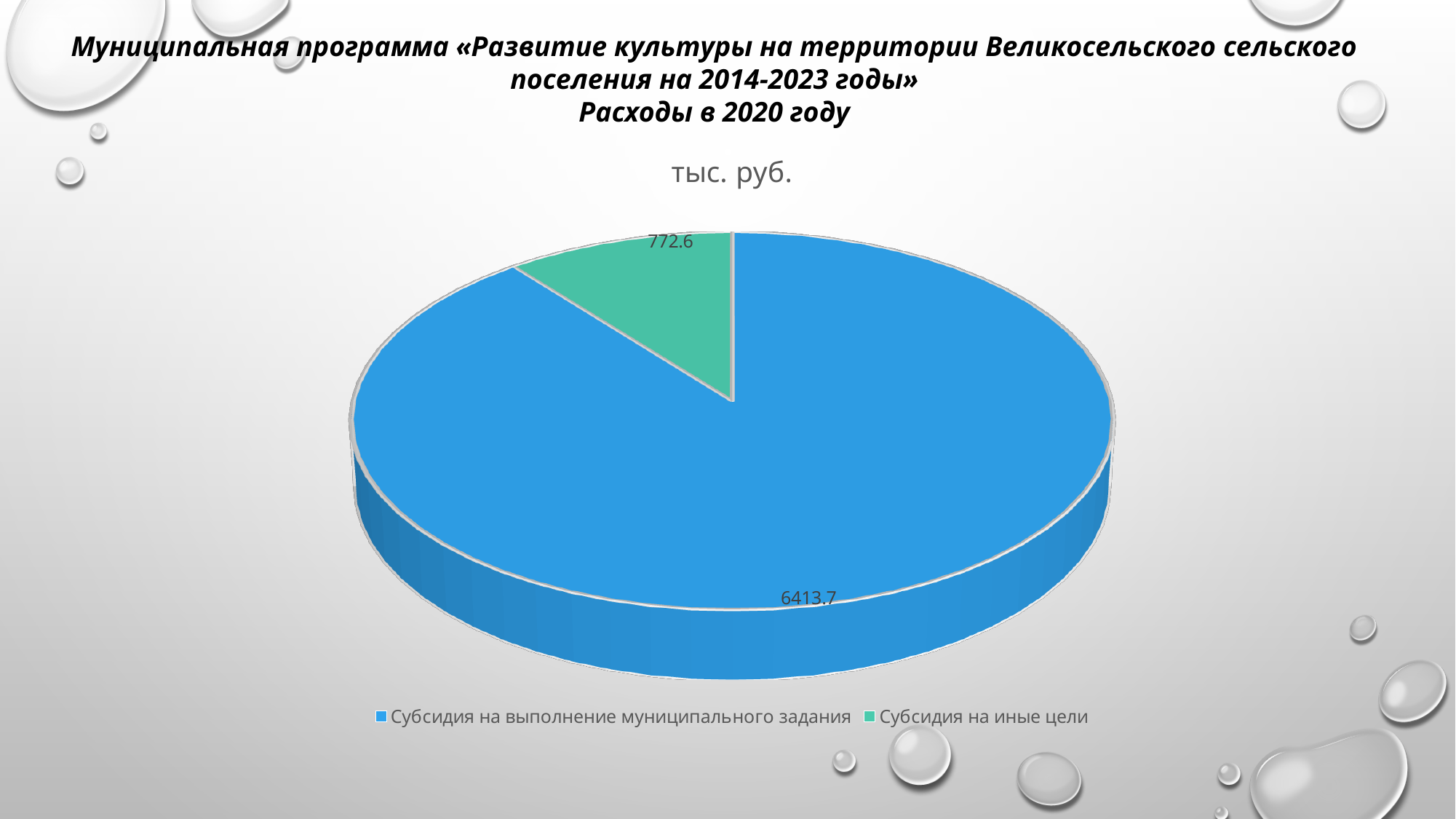
What is the difference between the values for «Субсидия на выполнение муниципального задания» and «Субсидия на иные цели»? 5641.1 How many slices does the pie chart have? 2 What is the value for «Субсидия на выполнение муниципального задания»? 6413.7 How many entries does the legend list? 2 What is the title shown above the pie chart? тыс. руб. Which category has the largest slice of the pie? Субсидия на выполнение муниципального задания What is the total of all slices in the pie chart? 7186.3 Which category has the smallest slice of the pie? Субсидия на иные цели What is the value for «Субсидия на иные цели»? 772.6 What type of chart is shown on the slide? Pie chart What share of the pie does «Субсидия на иные цели» represent, to one decimal place? 10.8% Which is larger: «Субсидия на выполнение муниципального задания» or «Субсидия на иные цели»? Субсидия на выполнение муниципального задания